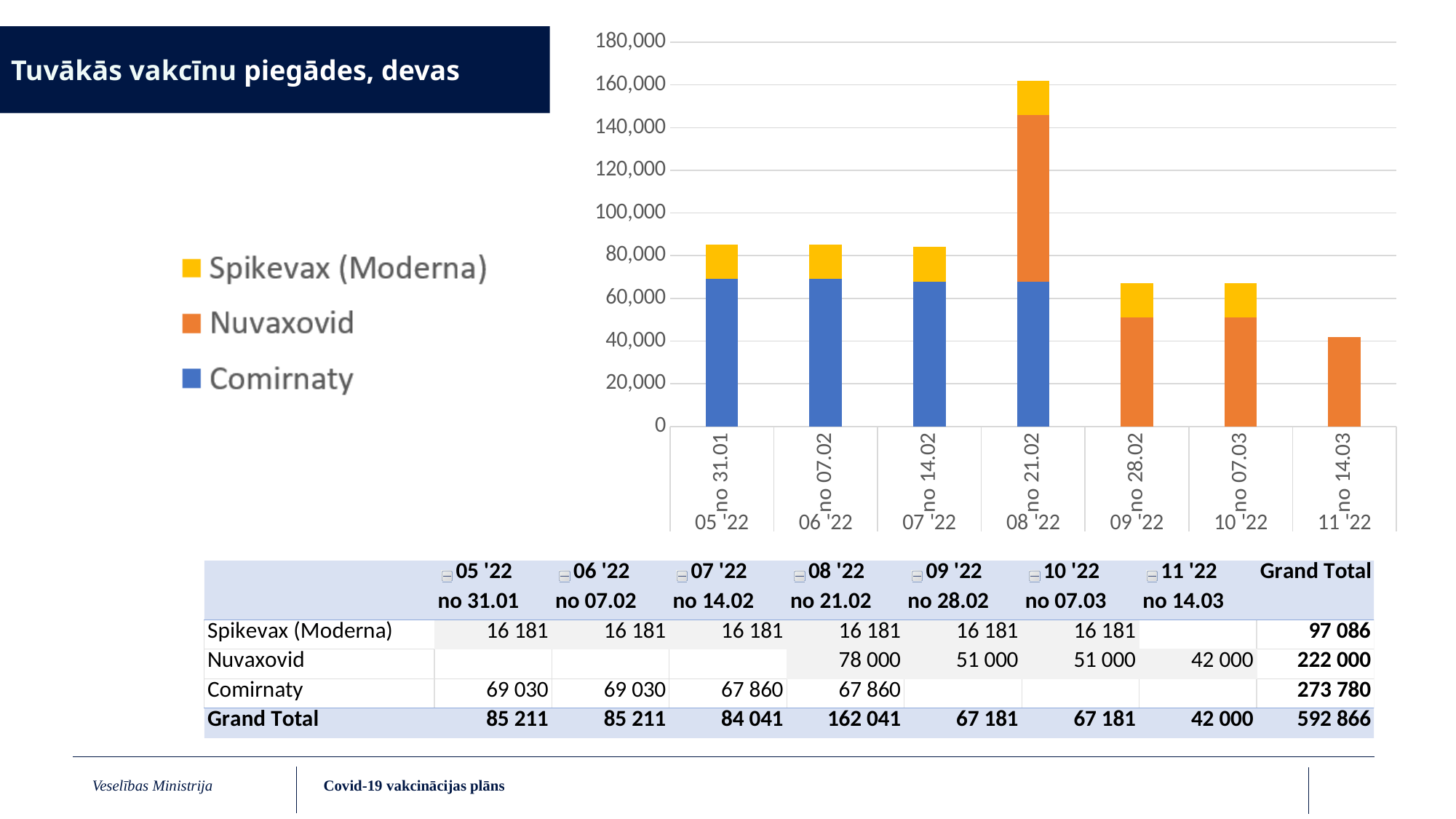
Is the total bar for the week 11 '22 no 14.03 greater or less than 60,000? less What is the Comirnaty value for the week 07 '22 no 14.02? 67 860 What type of chart is shown on the slide? bar chart Which week has the highest total stacked bar? 08 '22 no 21.02 Which is larger: the Comirnaty value for 05 '22 no 31.01 or the Nuvaxovid value for 09 '22 no 28.02? Comirnaty value for 05 '22 no 31.01 How many series does the chart legend list? 3 How many week categories are shown along the x axis of the chart? 7 What is the Nuvaxovid value for the week 08 '22 no 21.02? 78 000 Which colour represents Spikevax (Moderna) in the chart? yellow Which week has the lowest total stacked bar? 11 '22 no 14.03 What is the difference between the Grand Total for 08 '22 no 21.02 and the Grand Total for 07 '22 no 14.02? 78 000 What is the total of the stacked bar for the week 09 '22 no 28.02? 67 181